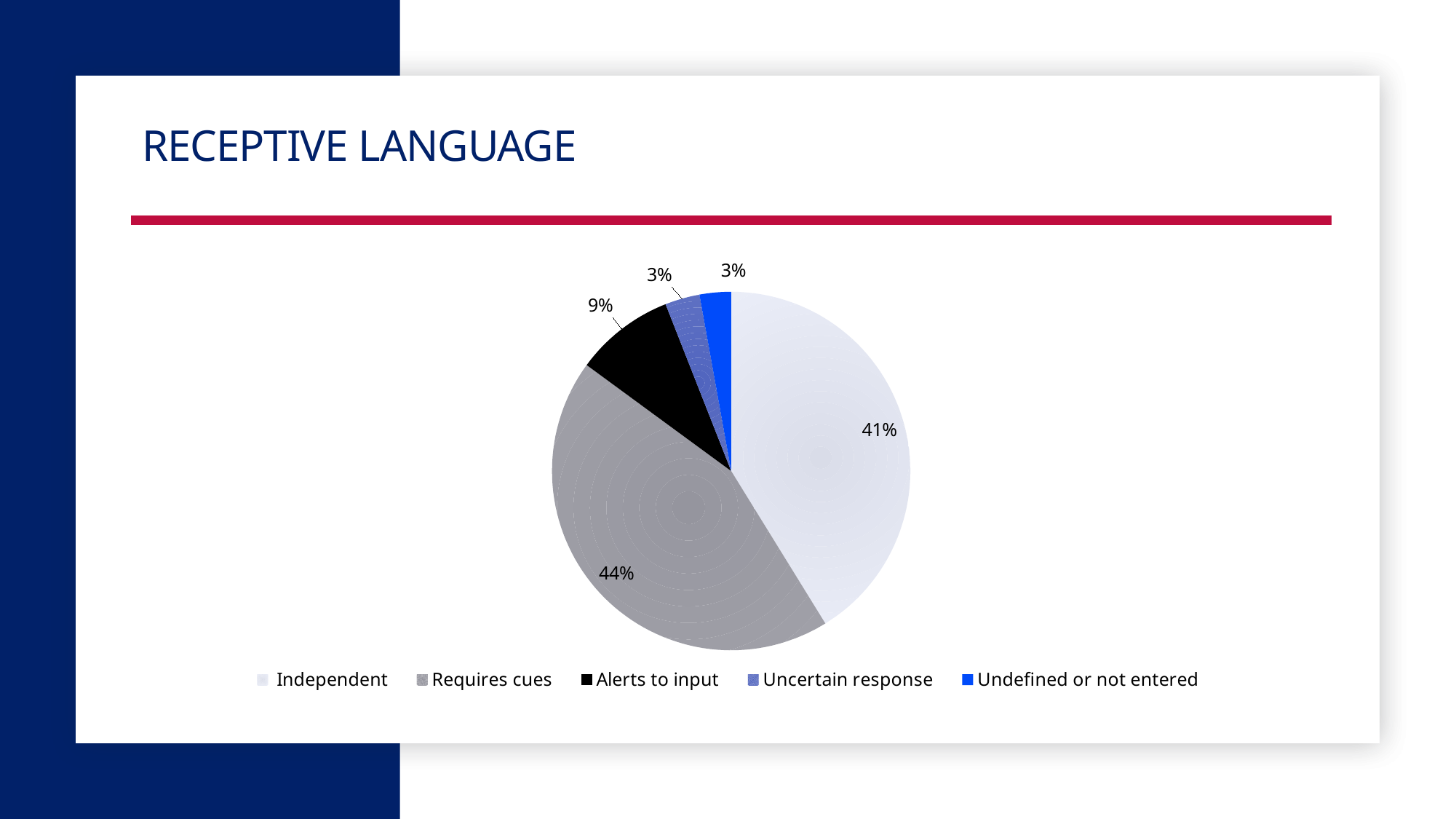
What percentage of the pie is labelled for Undefined or not entered? 3% What is the title of the slide containing the chart? RECEPTIVE LANGUAGE Which is larger, the share for Alerts to input or the share for Uncertain response? Alerts to input What percentage of the pie is labelled for Independent? 41% How many categories does the legend list? 5 What percentage of the pie is labelled for Alerts to input? 9% What is the difference in percentage points between Requires cues and Independent? 3 What percentage of the pie is labelled for Uncertain response? 3% What percentage of the pie is labelled for Requires cues? 44% What kind of chart is shown on the slide? pie chart What is the difference in percentage points between Independent and Alerts to input? 32 Which category has the largest share of the pie? Requires cues